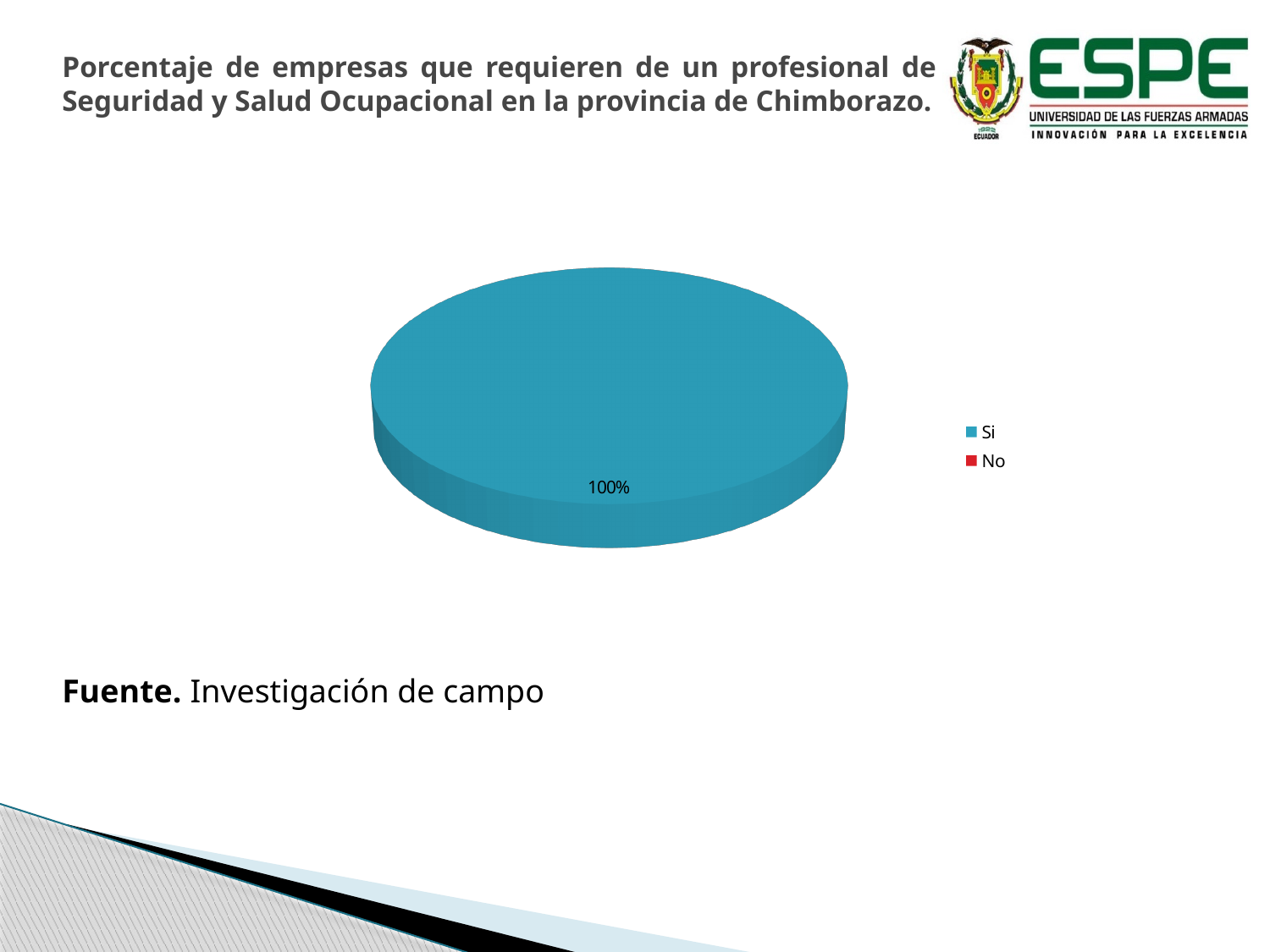
What colour is used for the "Si" category in the legend? blue Which of the two categories, Si or No, has the larger share of the pie? Si What colour is used for the "No" category in the legend? red Which category has the largest share of the pie chart? Si How many entries does the legend of the pie chart list? 2 What percentage is shown for the "Si" slice of the pie chart? 100% What kind of chart is shown on the slide? pie chart What share of the pie does the "Si" slice represent? 100% How many data labels are printed on the pie chart? 1